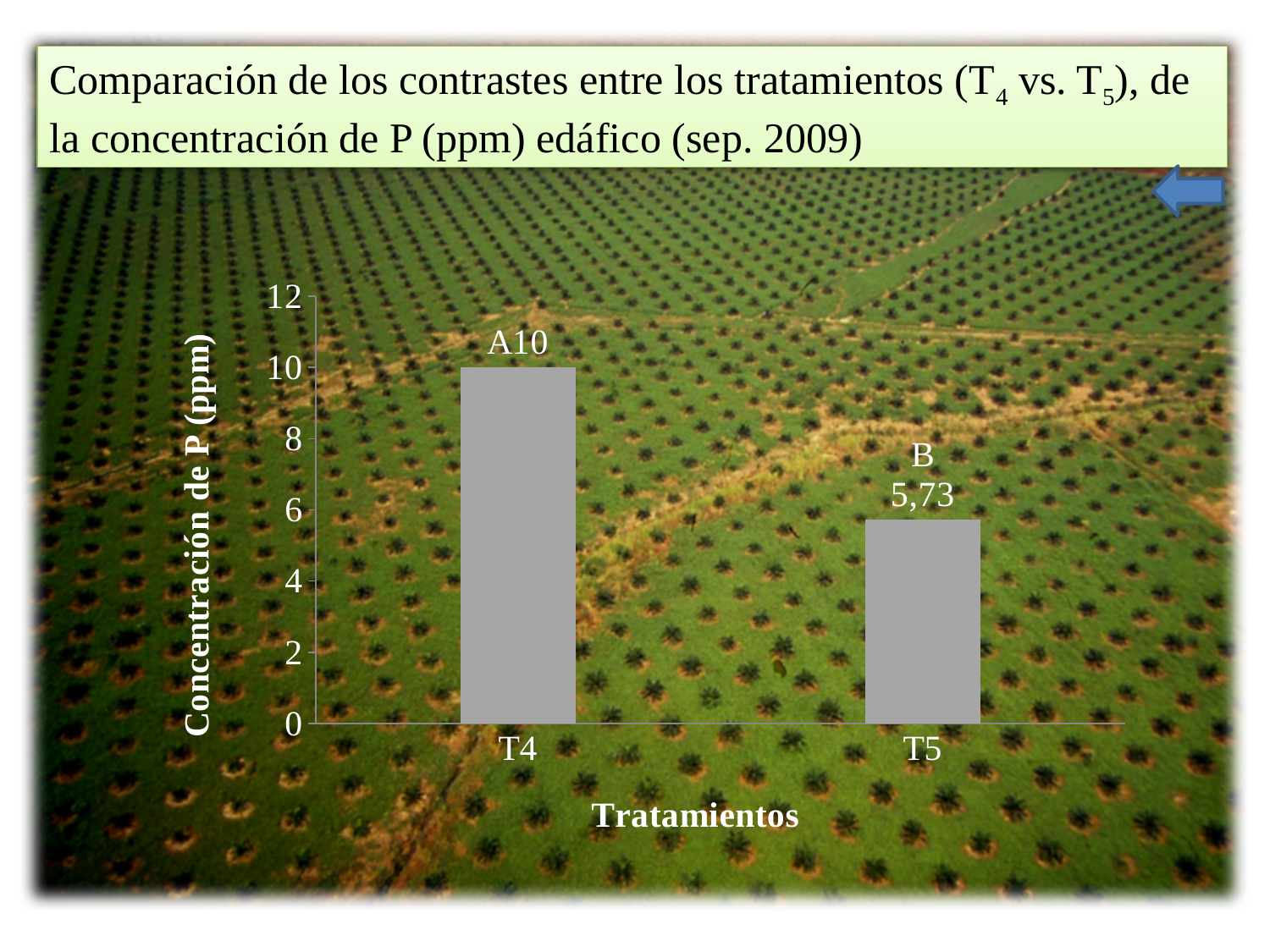
What is the difference between the P concentration values for T4 and T5? 4,27 Which has a larger P concentration, T4 or T5? T4 What kind of chart is shown on the slide? bar chart How many treatments are plotted on the chart? 2 What is the P concentration value shown for treatment T5? 5,73 What is the label of the y axis? Concentración de P (ppm) Which treatment has the highest P concentration? T4 What is the P concentration value shown for treatment T4? 10 Which treatment has the lowest P concentration? T5 Is the value for T4 greater or less than 8? greater Is the value for T5 greater or less than 6? less What statistical group letter is shown above the T5 bar? B